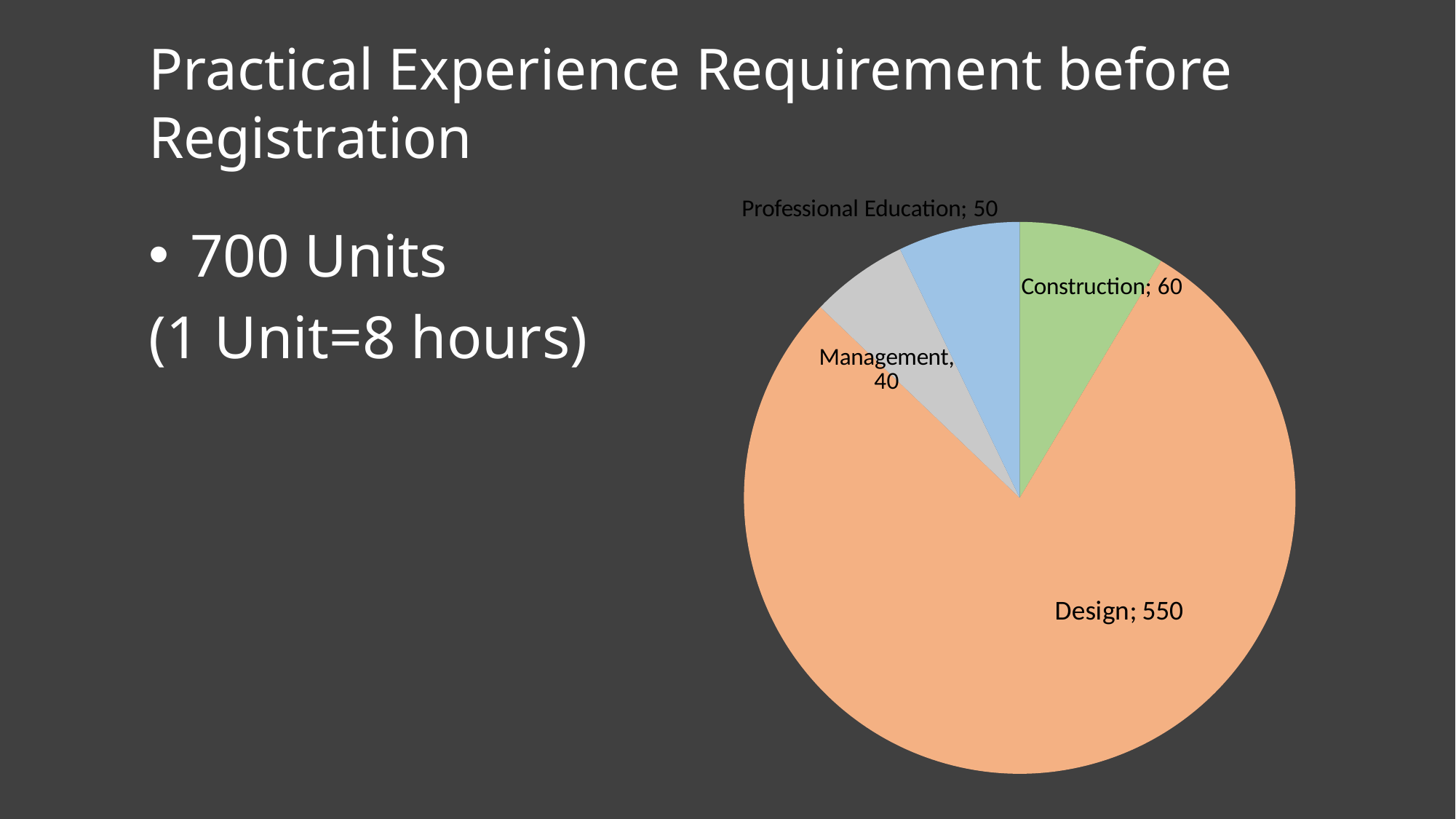
What is the total of all the slices in the pie chart? 700 What is the difference between the values for Design and Construction? 490 What is the value for Design in the pie chart? 550 Which category has the largest slice in the pie chart? Design Which is larger, the value for Construction or the value for Professional Education? Construction What is the value for Construction in the pie chart? 60 What kind of chart is shown on the slide? pie chart To the nearest whole percent, what share of the pie does Design represent? 79% What is the value for Professional Education in the pie chart? 50 How many slices does the pie chart have? 4 What is the value for Management in the pie chart? 40 Which category has the smallest slice in the pie chart? Management